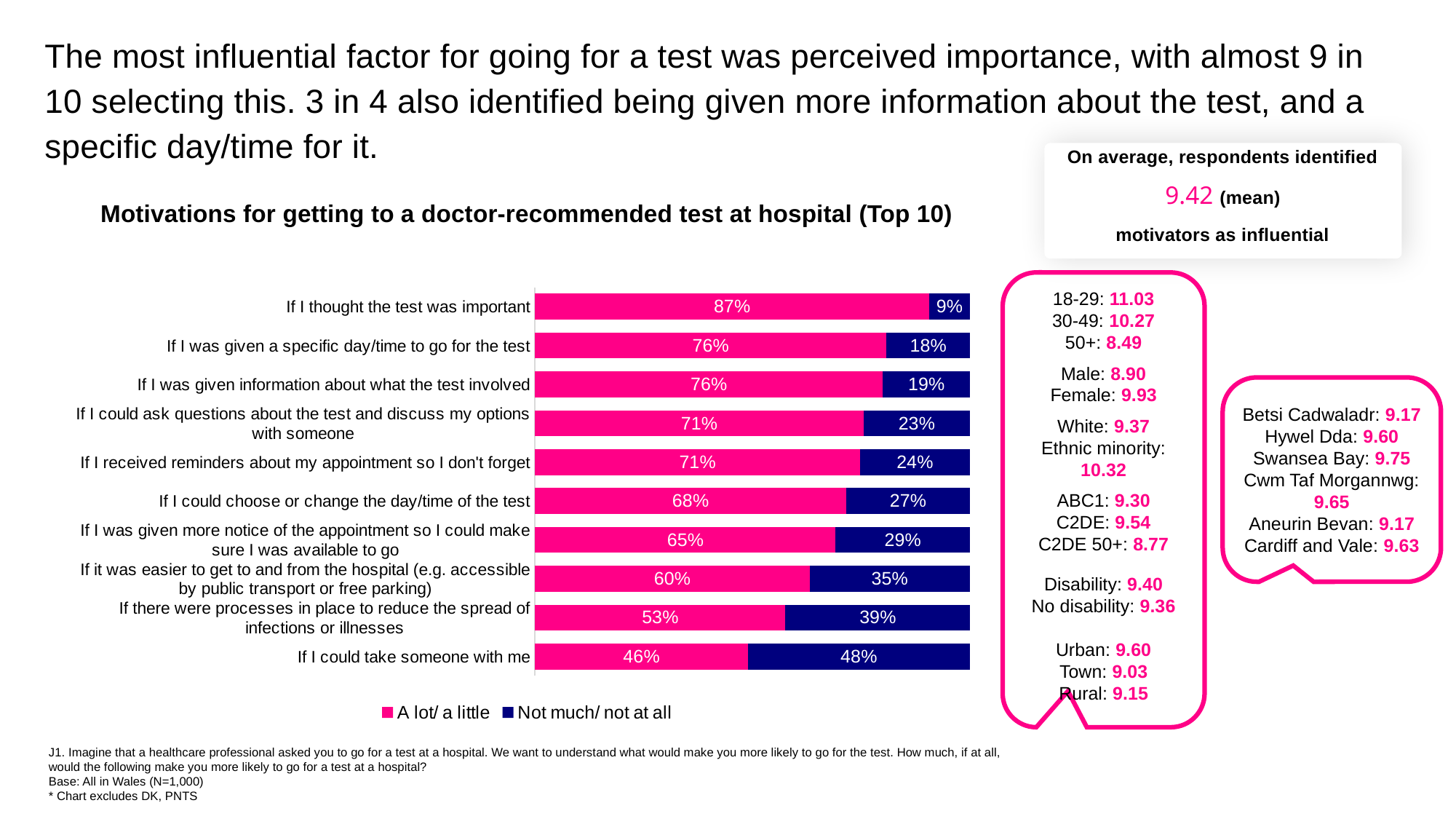
What is the title of the chart? Motivations for getting to a doctor-recommended test at hospital (Top 10) What percentage said 'Not much/ not at all' for 'If I could take someone with me'? 48% How many motivations are shown in the chart? 10 Which motivation has the highest 'A lot/ a little' percentage? If I thought the test was important What is the difference between the 'A lot/ a little' values for 'If I thought the test was important' and 'If I could take someone with me'? 41 percentage points How many series does the legend list? 2 Which motivation has the lowest 'A lot/ a little' percentage? If I could take someone with me What percentage said 'A lot/ a little' for 'If I thought the test was important'? 87% What kind of chart is shown on the slide? Stacked horizontal bar chart What is the 'A lot/ a little' value for 'If it was easier to get to and from the hospital (e.g. accessible by public transport or free parking)'? 60% What is the total of the two labelled segments for 'If there were processes in place to reduce the spread of infections or illnesses'? 92% Which has a larger 'Not much/ not at all' share: 'If I received reminders about my appointment so I don't forget' or 'If I could choose or change the day/time of the test'? If I could choose or change the day/time of the test